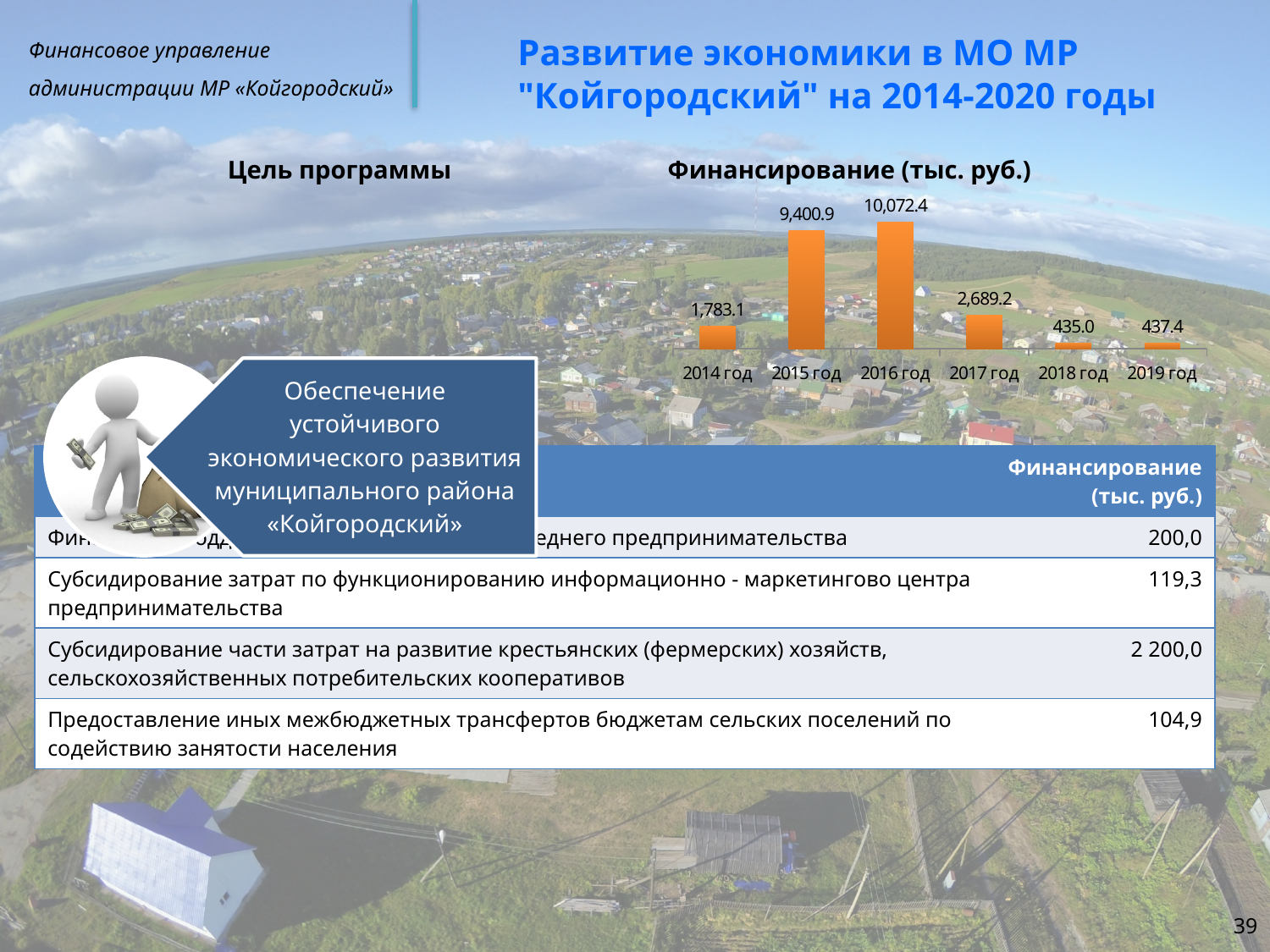
What kind of chart is "Финансирование (тыс. руб.)"? Bar chart What is the value for 2017 год in the chart "Финансирование (тыс. руб.)"? 2,689.2 What is the value for 2016 год in the chart "Финансирование (тыс. руб.)"? 10,072.4 What is the value for 2014 год in the chart "Финансирование (тыс. руб.)"? 1,783.1 What is the difference between the values for 2017 год and 2014 год in the chart "Финансирование (тыс. руб.)"? 906.1 What is the difference between the values for 2016 год and 2015 год in the chart "Финансирование (тыс. руб.)"? 671.5 Which year has the lowest value in the chart "Финансирование (тыс. руб.)"? 2018 год What is the title of the bar chart on the slide? Финансирование (тыс. руб.) In the chart "Финансирование (тыс. руб.)", do the values rise or fall from 2016 год to 2018 год? Fall In the chart "Финансирование (тыс. руб.)", which is larger: the value for 2015 год or the value for 2017 год? 2015 год Which year has the highest value in the chart "Финансирование (тыс. руб.)"? 2016 год How many years are shown in the chart "Финансирование (тыс. руб.)"? 6